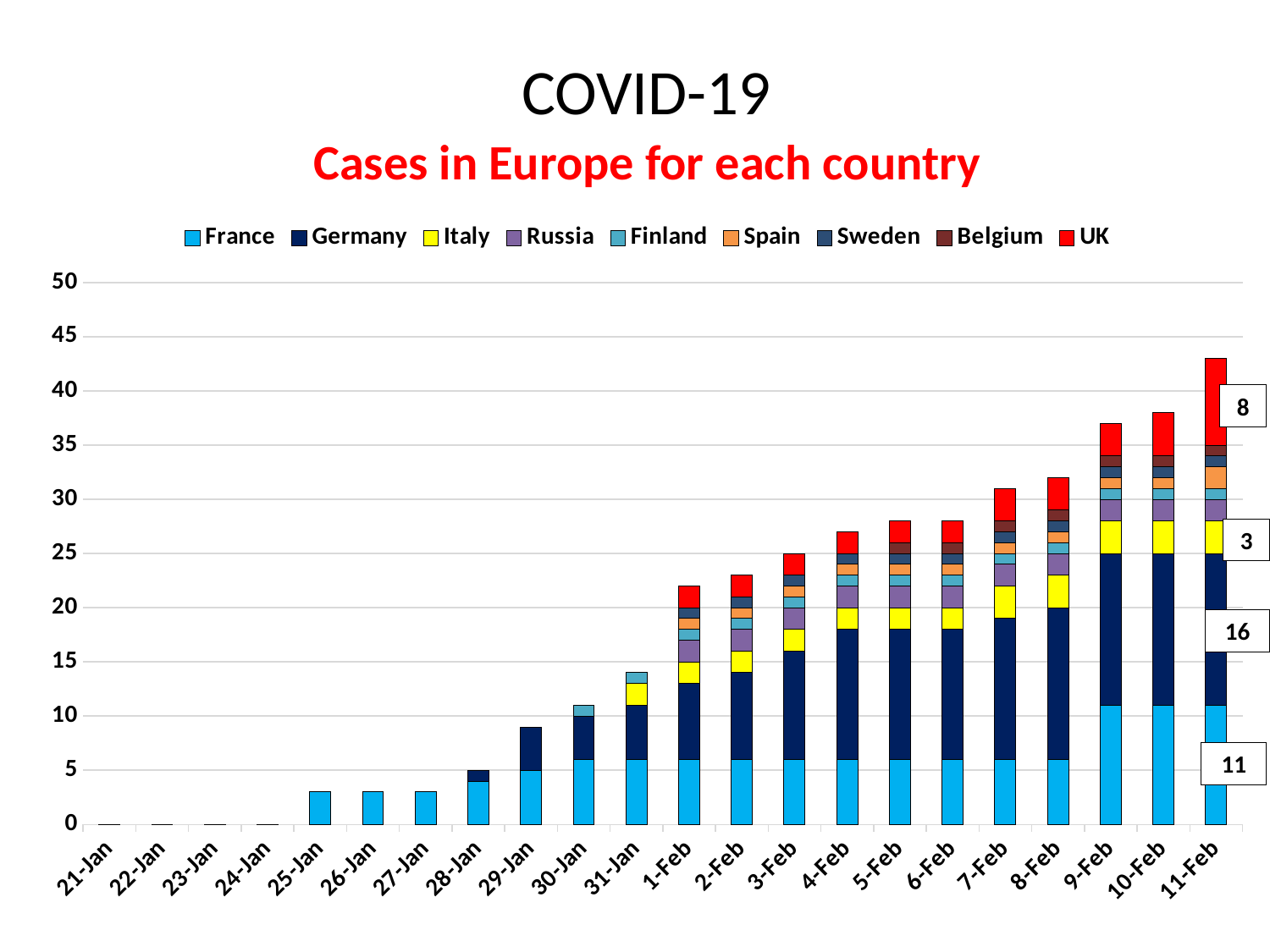
Which date has the highest total stacked value? 11-Feb On 11-Feb, which is larger: the value for Germany or the value for France? Germany Do the total stacked values generally rise or fall from 21-Jan to 11-Feb? rise What kind of chart is shown on the slide? stacked bar chart How many dates are shown along the x axis? 22 What is the value for the UK on 11-Feb? 8 On 11-Feb, what is the difference between the value for Germany and the value for France? 5 What is the value for Italy on 11-Feb? 3 How many series does the legend list? 9 Is the total stacked value for 11-Feb greater or less than 40? greater What is the value for Germany on 11-Feb? 16 What is the value for France on 11-Feb? 11